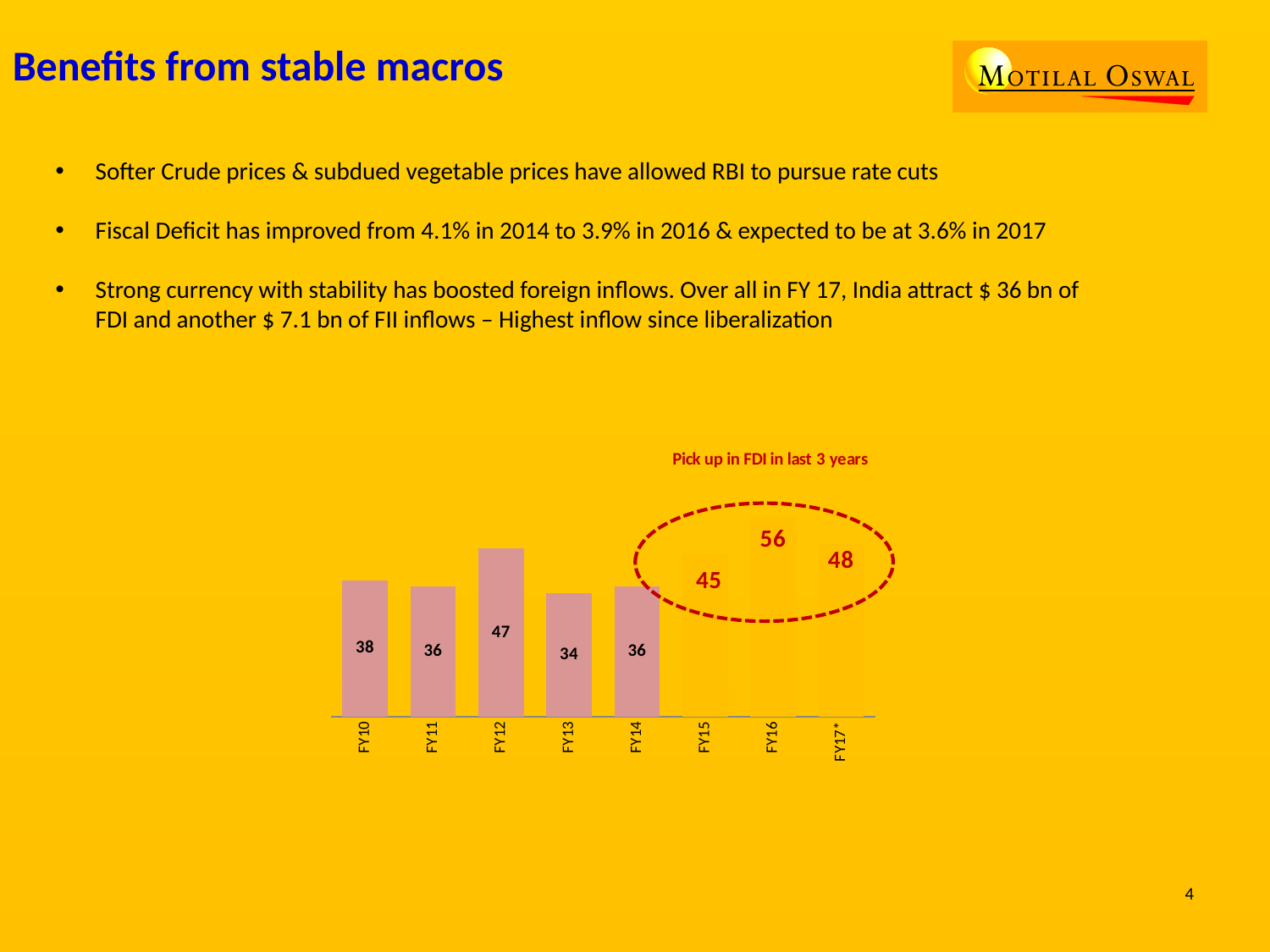
What is the value for FY16? 56 Which is larger, the value for FY15 or the value for FY14? FY15 What text is written above the circled bars? Pick up in FDI in last 3 years Which year has the highest value? FY16 Do the values rise or fall from FY14 to FY16? rise What is the value for FY17*? 48 Which year has the lowest value? FY13 What is the difference between the values for FY12 and FY13? 13 How many years are shown on the x axis? 8 What is the difference between the values for FY16 and FY15? 11 What is the value for FY12? 47 What kind of chart is this? bar chart